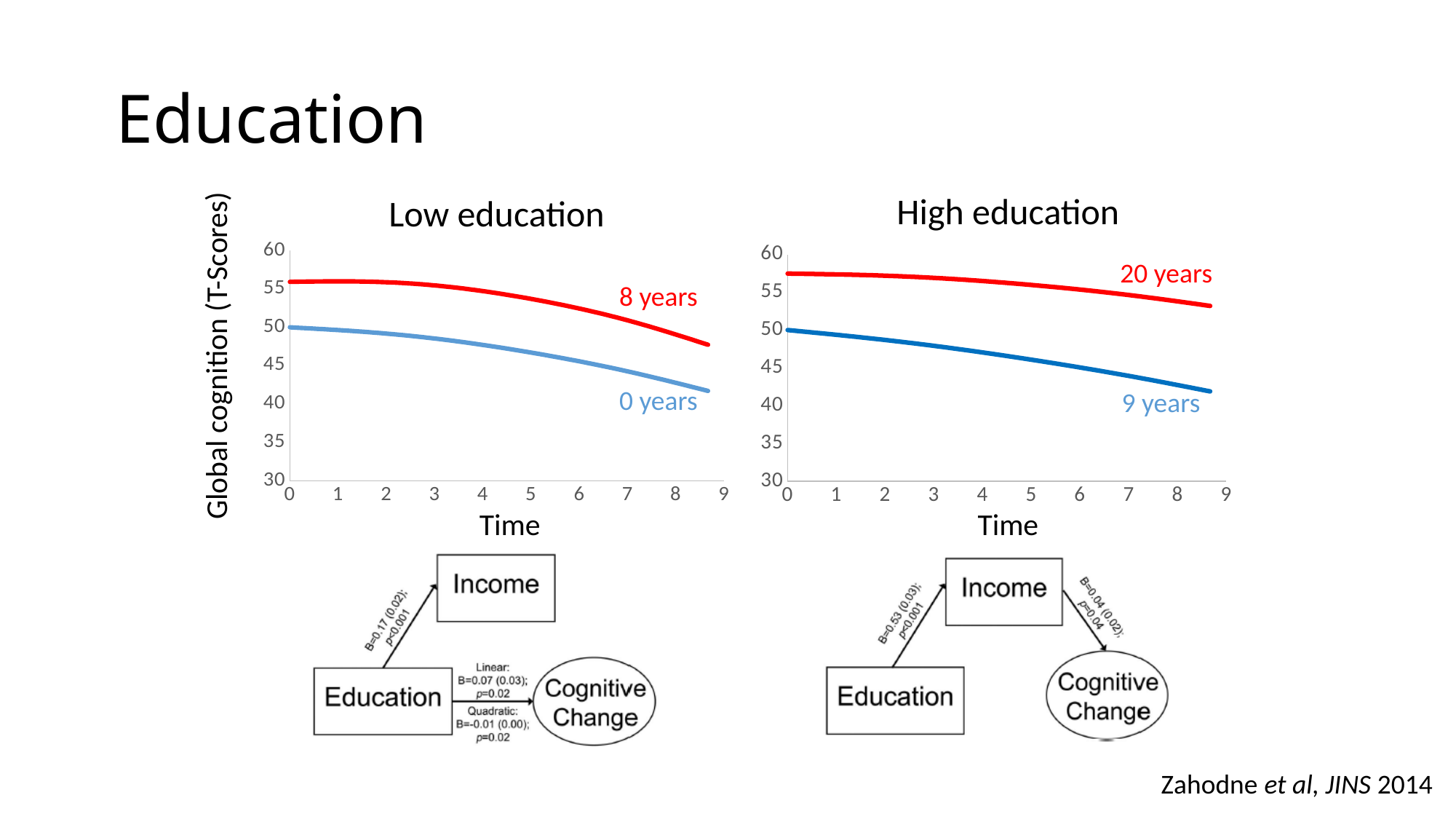
What kind of chart is the "Low education" chart? line chart In the "High education" chart, which line is higher at Time 8: "20 years" or "9 years"? 20 years In the "Low education" chart, do the values rise or fall as Time increases? fall In the "Low education" chart, is the value of the "8 years" line at Time 8 greater or less than 50? less In the "High education" chart, how many lines (series) are plotted? 2 What is the title of the chart on the right? High education In the "Low education" chart, which line is higher at Time 0: "8 years" or "0 years"? 8 years What is the y-axis label shared by the two charts? Global cognition (T-Scores) In the "High education" chart, is the value of the "9 years" line at Time 8 greater or less than 45? less In the "High education" chart, does the "20 years" line rise or fall over Time? fall In the "Low education" chart, is the value of the "0 years" line at Time 0 greater or less than 45? greater